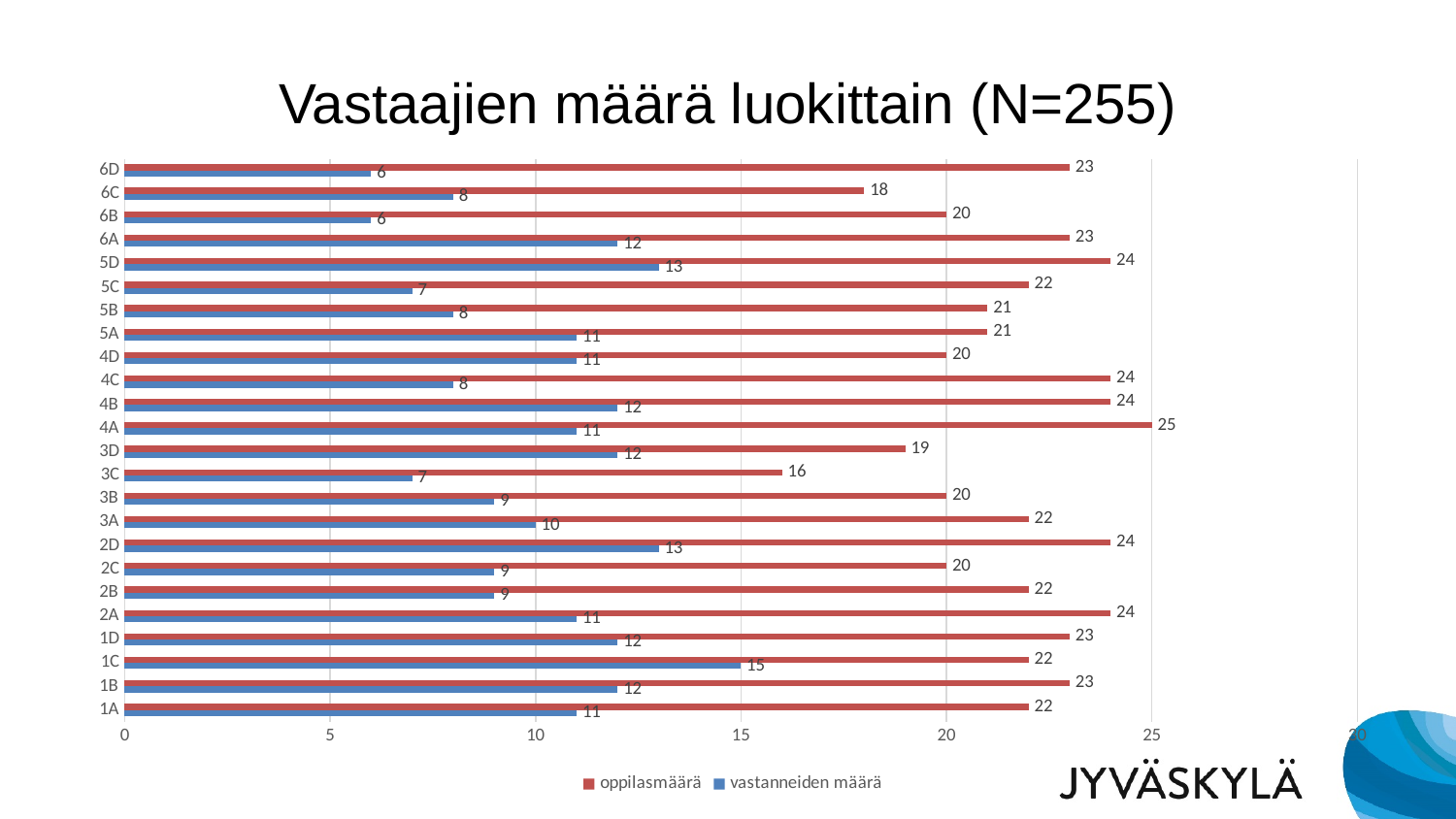
How many series does the legend list? 2 Which class has the lowest oppilasmäärä? 3C Which is larger, the vastanneiden määrä for 5D or for 5C? 5D What is the vastanneiden määrä value for class 1C? 15 What is the oppilasmäärä value for class 3C? 16 Which class has the highest vastanneiden määrä? 1C What is the oppilasmäärä value for class 4A? 25 What is the title of the chart? Vastaajien määrä luokittain (N=255) Which class has the highest oppilasmäärä? 4A How many classes are shown on the chart? 24 What kind of chart is shown on the slide? Bar chart What is the difference between oppilasmäärä and vastanneiden määrä for class 6D? 17